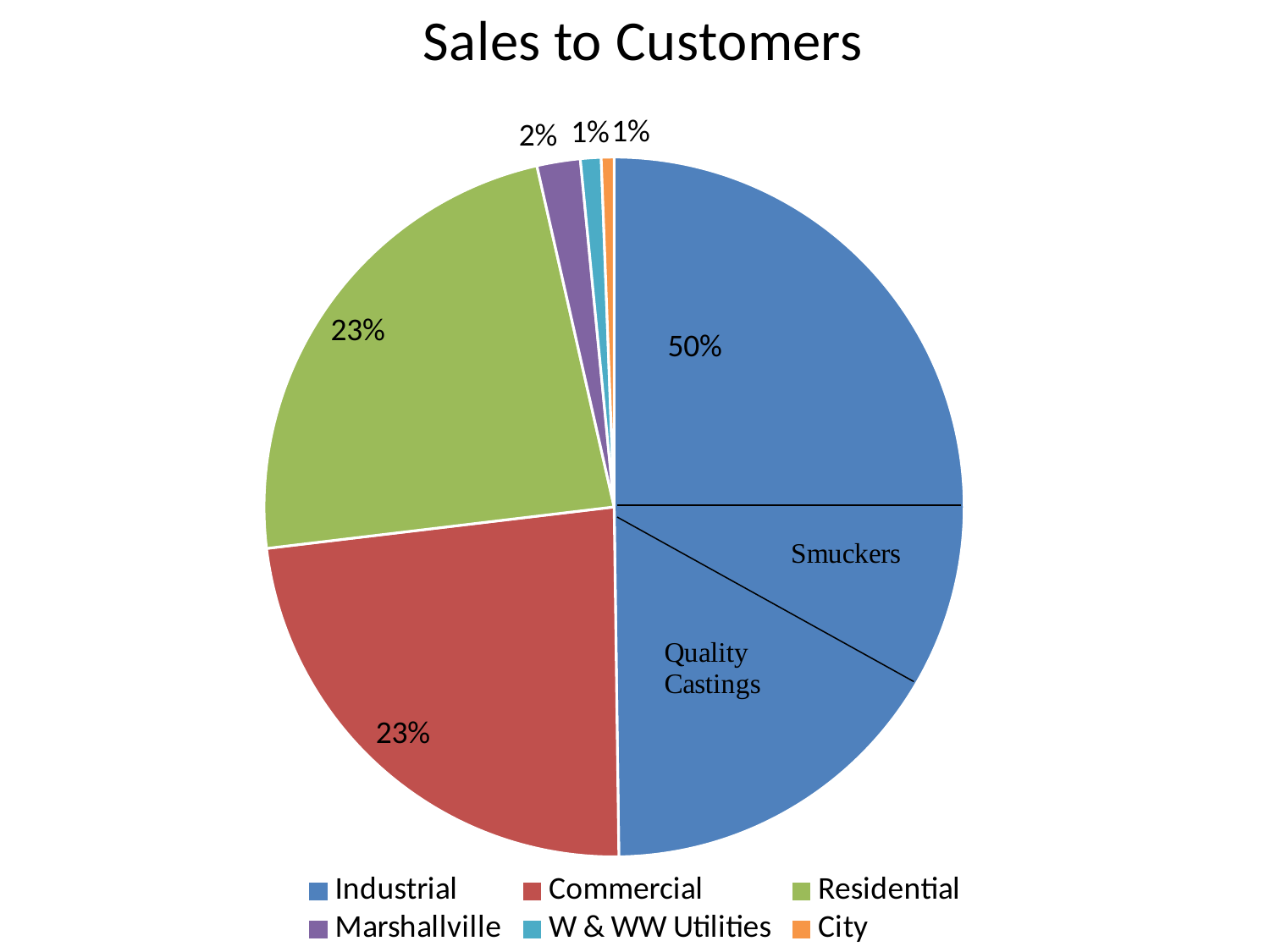
What is the title of the chart? Sales to Customers What percentage is shown for the City slice? 1% Which two customer names are annotated inside the Industrial slice? Smuckers and Quality Castings What percentage is shown for the Residential slice? 23% Which category has the largest share of the pie? Industrial Which slice is larger, Marshallville or W & WW Utilities? Marshallville What percentage is shown for the Commercial slice? 23% What is the difference in percentage points between the Industrial and Commercial slices? 27 What share of sales does the Industrial slice represent? 50% What type of chart is shown on the slide? pie chart What percentage is shown for the Marshallville slice? 2% How many categories does the legend list? 6